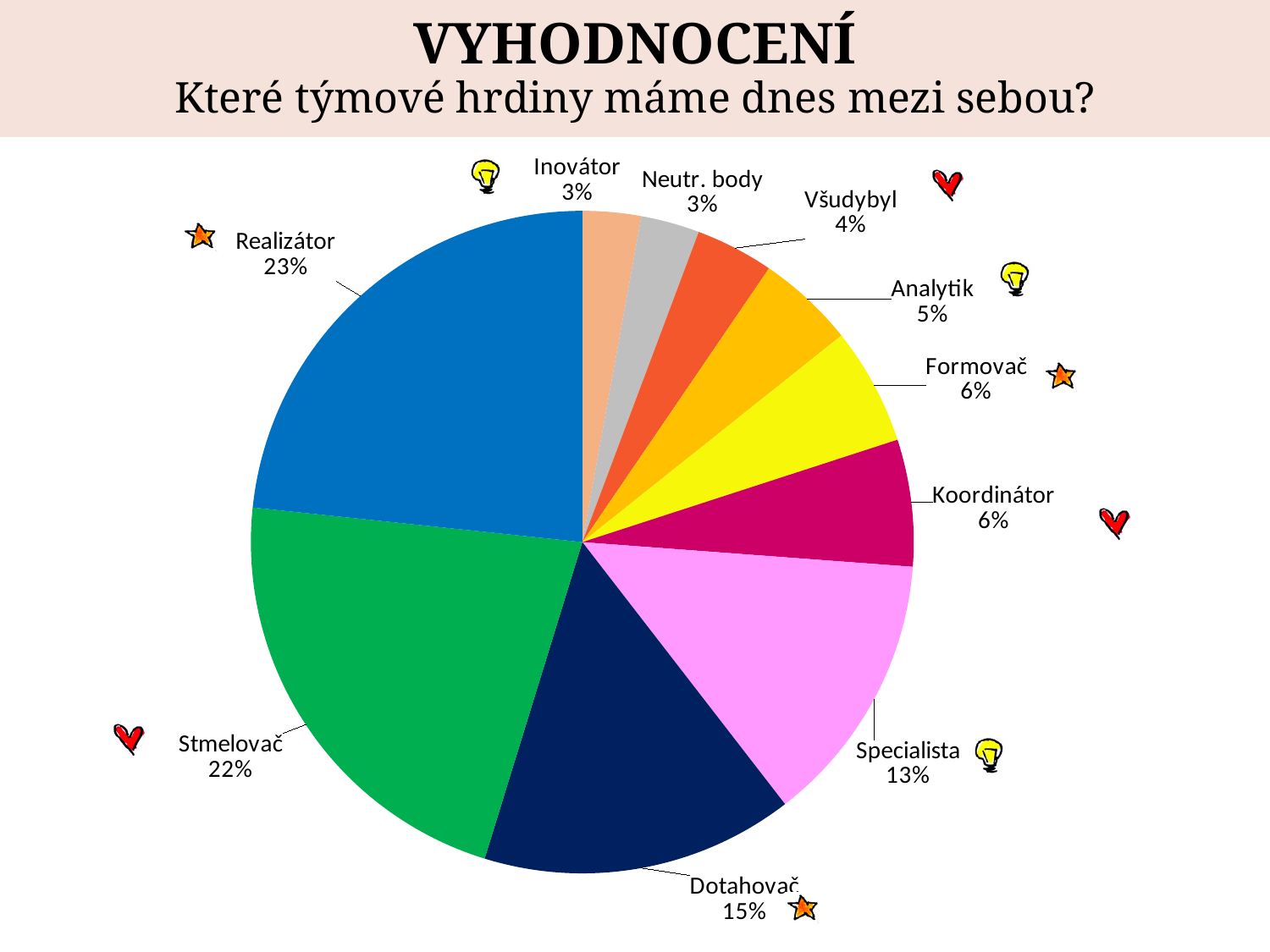
What share of the pie does Realizátor have? 23% What share of the pie does Dotahovač have? 15% What is the difference between the shares for Realizátor and Stmelovač? 1% What share of the pie does Specialista have? 13% What share of the pie does Analytik have? 5% What is the difference between the shares for Dotahovač and Specialista? 2% What share of the pie does Všudybyl have? 4% What is the subtitle question written above the pie chart? Které týmové hrdiny máme dnes mezi sebou? How many slices does the pie chart have? 10 Which category has the largest share of the pie? Realizátor What kind of chart is shown on the slide? pie chart Which is larger, the share for Stmelovač or the share for Dotahovač? Stmelovač